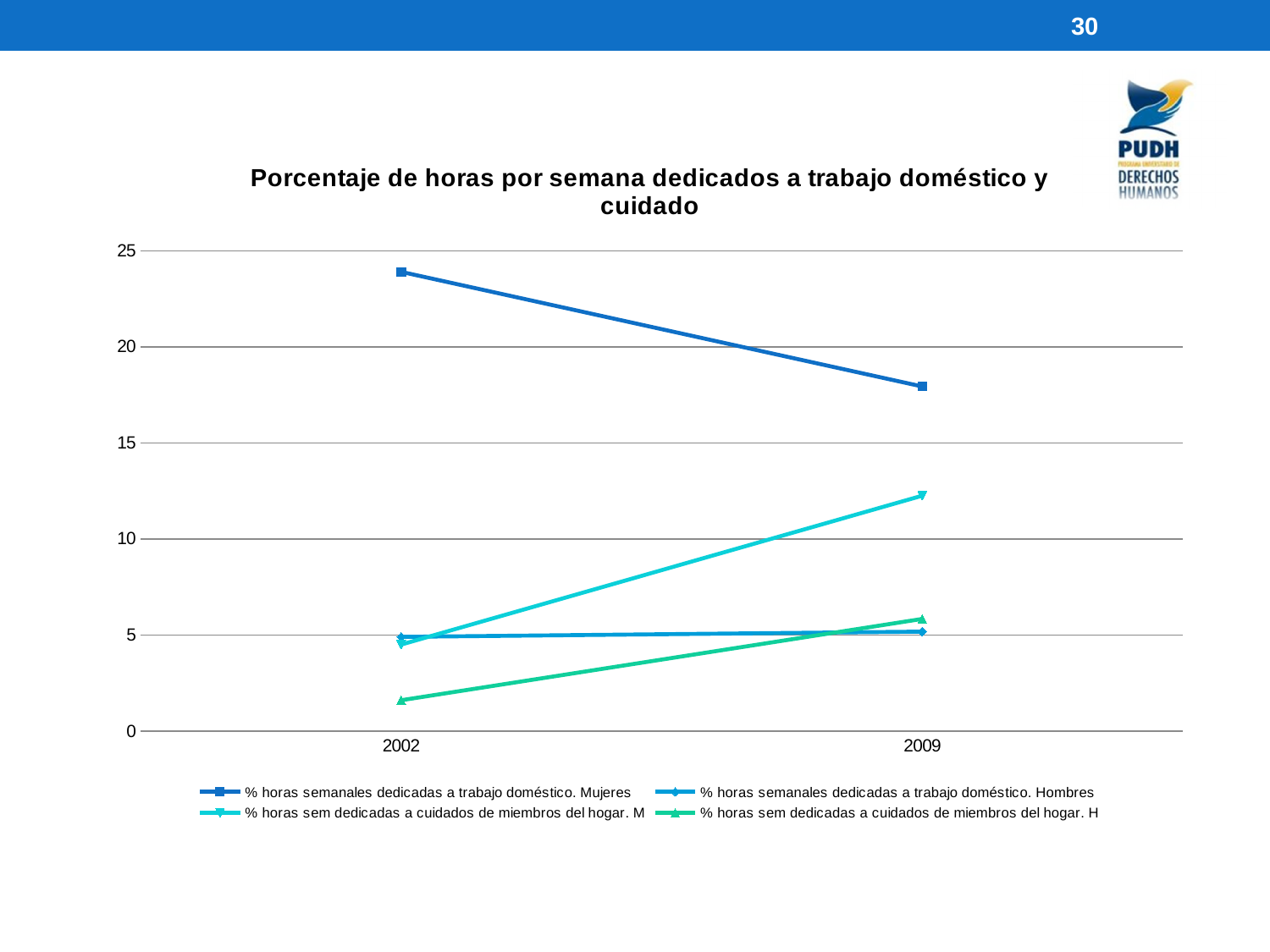
Which series has the lowest value in 2002? % horas sem dedicadas a cuidados de miembros del hogar. H Which series has the highest value in 2009? % horas semanales dedicadas a trabajo doméstico. Mujeres Is the 2002 value for '% horas semanales dedicadas a trabajo doméstico. Mujeres' greater or less than 20? greater Is the 2009 value for '% horas sem dedicadas a cuidados de miembros del hogar. M' greater or less than 10? greater Is the 2009 value for '% horas semanales dedicadas a trabajo doméstico. Mujeres' greater or less than 20? less How many years are shown on the x axis? 2 How many series does the legend list? 4 Does the series '% horas sem dedicadas a cuidados de miembros del hogar. H' rise or fall from 2002 to 2009? rise In 2009, which is larger: '% horas sem dedicadas a cuidados de miembros del hogar. M' or '% horas semanales dedicadas a trabajo doméstico. Hombres'? % horas sem dedicadas a cuidados de miembros del hogar. M What kind of chart is shown on the slide? line chart Does the series '% horas sem dedicadas a cuidados de miembros del hogar. M' rise or fall from 2002 to 2009? rise Does the series '% horas semanales dedicadas a trabajo doméstico. Mujeres' rise or fall from 2002 to 2009? fall